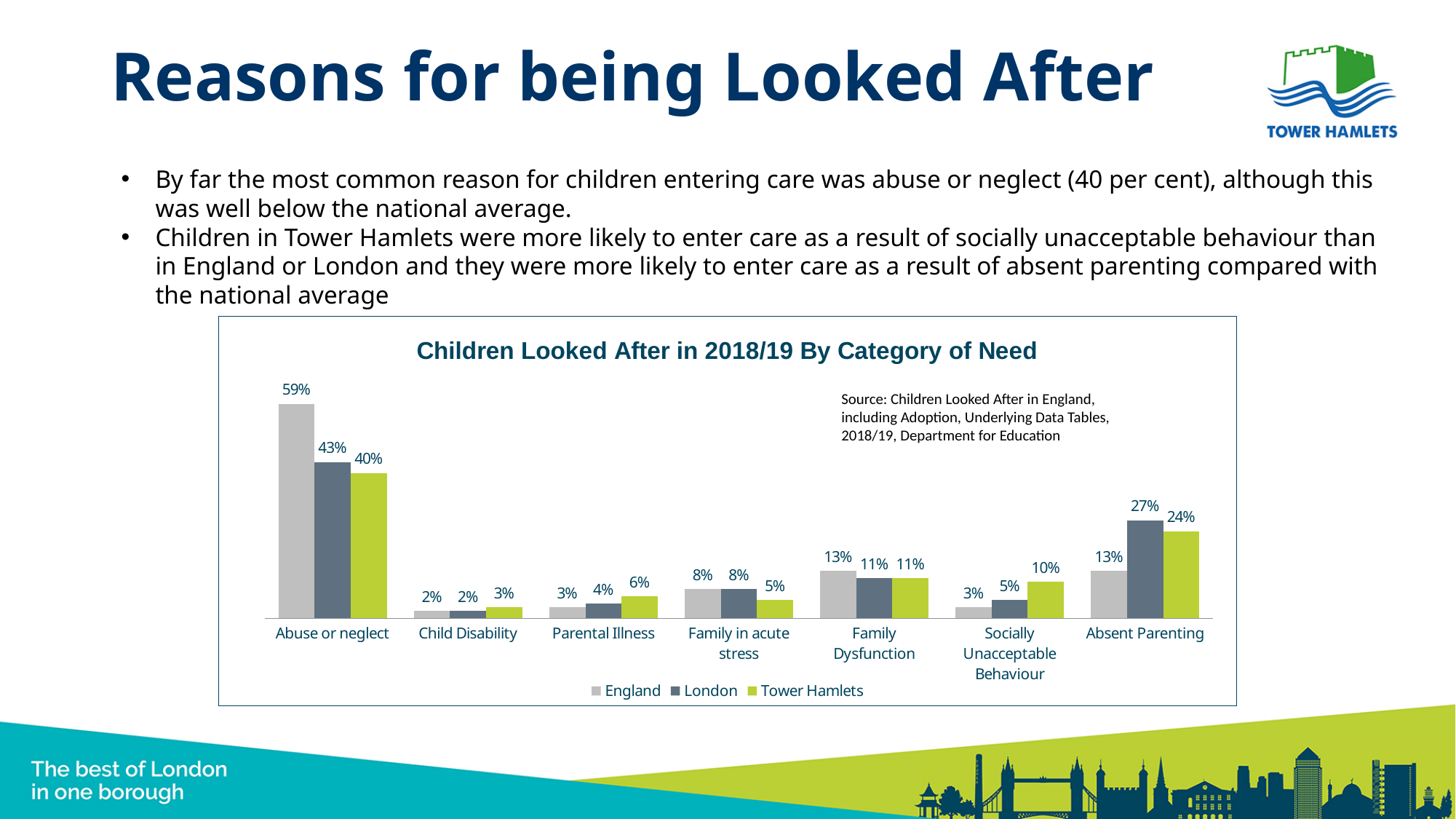
Which category has the highest value for England? Abuse or neglect What is the difference between the England and Tower Hamlets values for Abuse or neglect? 19% What is the title of the chart? Children Looked After in 2018/19 By Category of Need What is the difference between the Tower Hamlets and England values for Socially Unacceptable Behaviour? 7% What is the value for London in the Socially Unacceptable Behaviour category? 5% What is the value for Tower Hamlets in the Abuse or neglect category? 40% What kind of chart is shown on the slide? Bar chart What is the value for England in the Absent Parenting category? 13% How many categories of need are shown on the x axis? 7 Which category has the lowest value for London? Child Disability How many series does the legend list? 3 Which is larger for Absent Parenting: the London value or the Tower Hamlets value? London